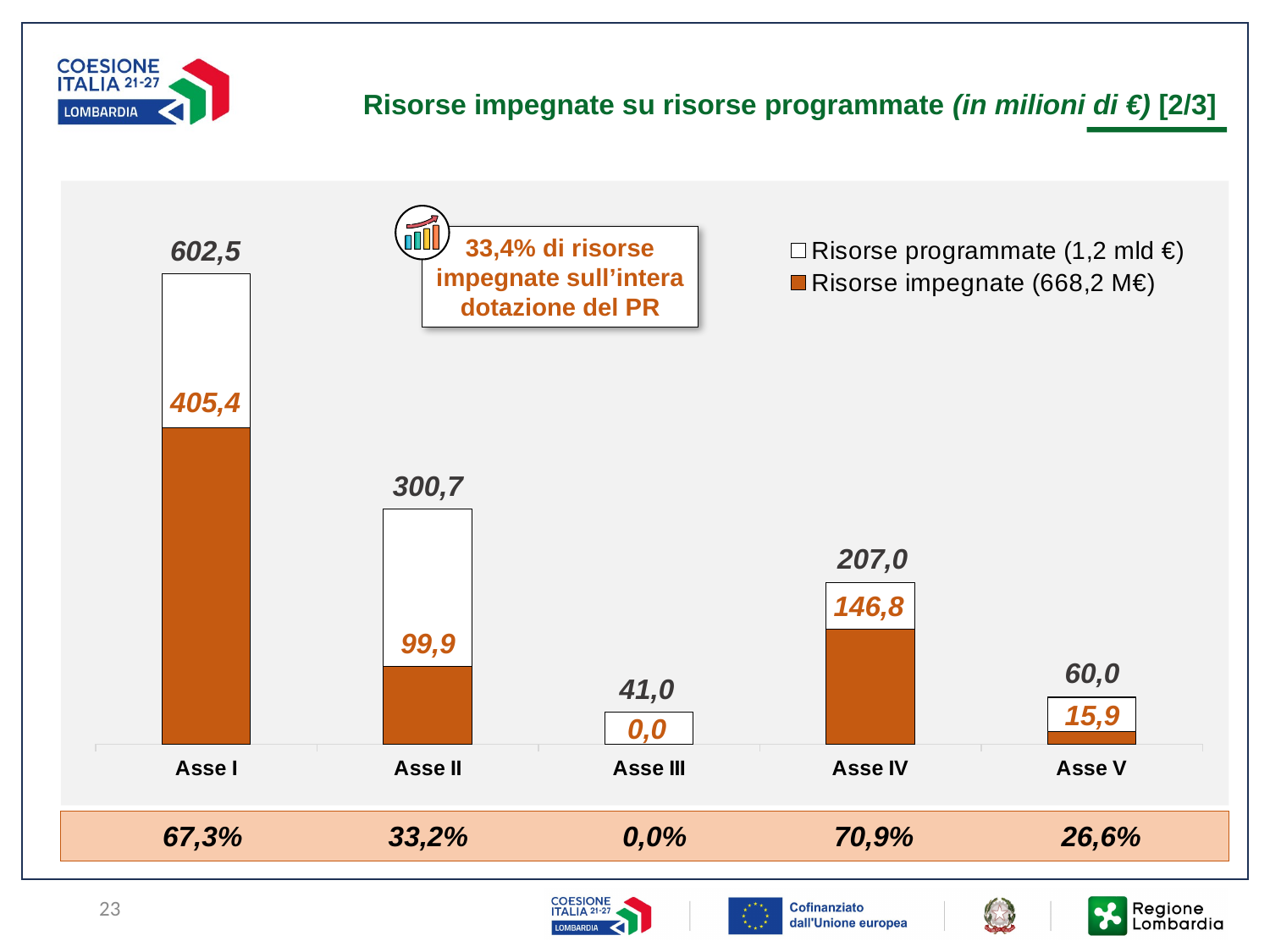
Which is larger: Risorse impegnate for Asse II or Risorse impegnate for Asse IV? Asse IV What kind of chart is shown on the slide? Bar chart What is the value of Risorse programmate for Asse V? 60,0 What is the difference between Risorse programmate and Risorse impegnate for Asse I? 197,1 What is the difference between Risorse programmate and Risorse impegnate for Asse IV? 60,2 What is the value of Risorse impegnate for Asse IV? 146,8 Which Asse has the lowest value of Risorse impegnate? Asse III How many Asse categories are shown on the x axis? 5 Which Asse has the highest value of Risorse programmate? Asse I What is the value of Risorse impegnate for Asse II? 99,9 How many series does the legend list? 2 What is the value of Risorse programmate for Asse I? 602,5